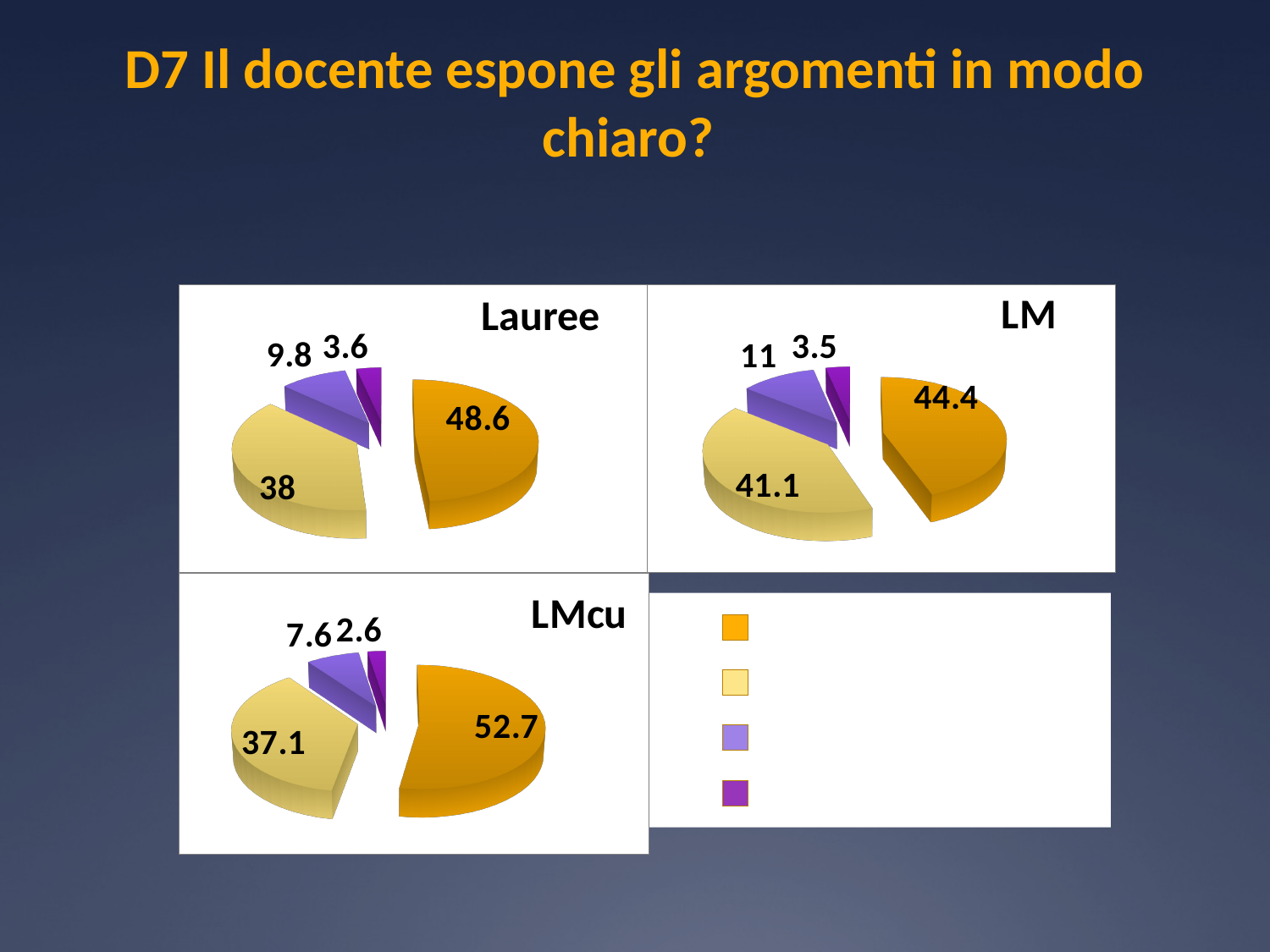
In the LMcu chart, which slice has the largest value? The orange slice (52.7) How many slices does the LM pie chart have? 4 In the Lauree chart, what is the value of the orange slice? 48.6 In the LM chart, what is the value of the light yellow slice? 41.1 In the LM chart, what is the difference between the orange slice and the light yellow slice? 3.3 What kind of chart is the Lauree chart? Pie chart In the LMcu chart, what is the value of the dark purple slice? 2.6 Which is larger: the orange slice in the LMcu chart or the orange slice in the LM chart? The orange slice in the LMcu chart (52.7) How many pie charts are shown on the slide? 3 In the Lauree chart, which slice has the smallest value? The dark purple slice (3.6) In the LM chart, what is the value of the lavender slice? 11 In the Lauree chart, what is the difference between the lavender slice and the dark purple slice? 6.2